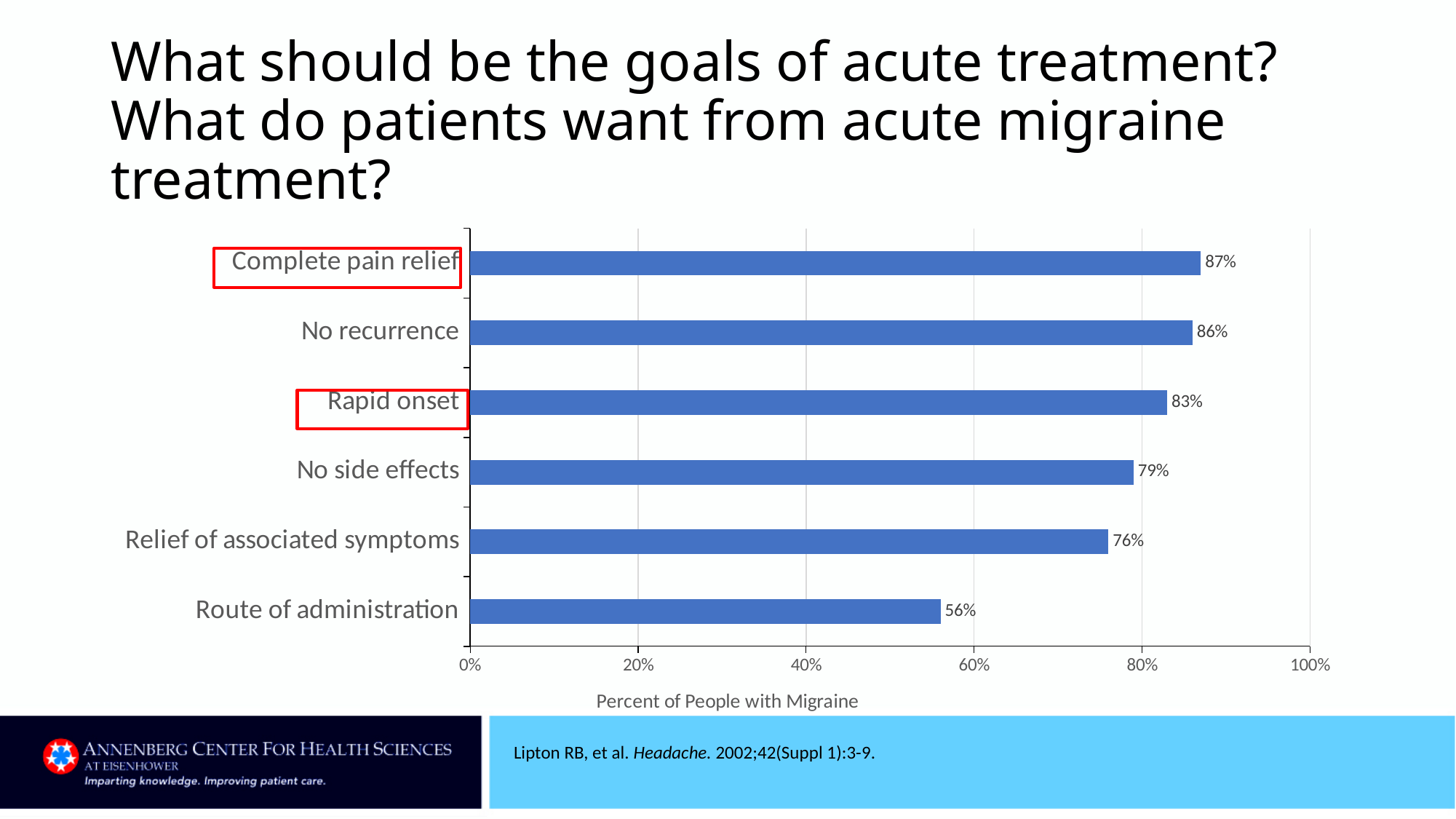
What percentage of people with migraine want complete pain relief? 87% Which category has the lowest value? Route of administration What is the value for Relief of associated symptoms? 76% What is the label of the horizontal axis? Percent of People with Migraine What is the value for No side effects? 79% What kind of chart is shown on the slide? Bar chart What is the difference between the values for No recurrence and No side effects? 7% Which is larger, the value for Rapid onset or the value for Relief of associated symptoms? Rapid onset How many categories are shown in the bar chart? 6 What is the difference between the values for Rapid onset and Route of administration? 27% What is the value for Route of administration? 56% Which category has the highest value? Complete pain relief